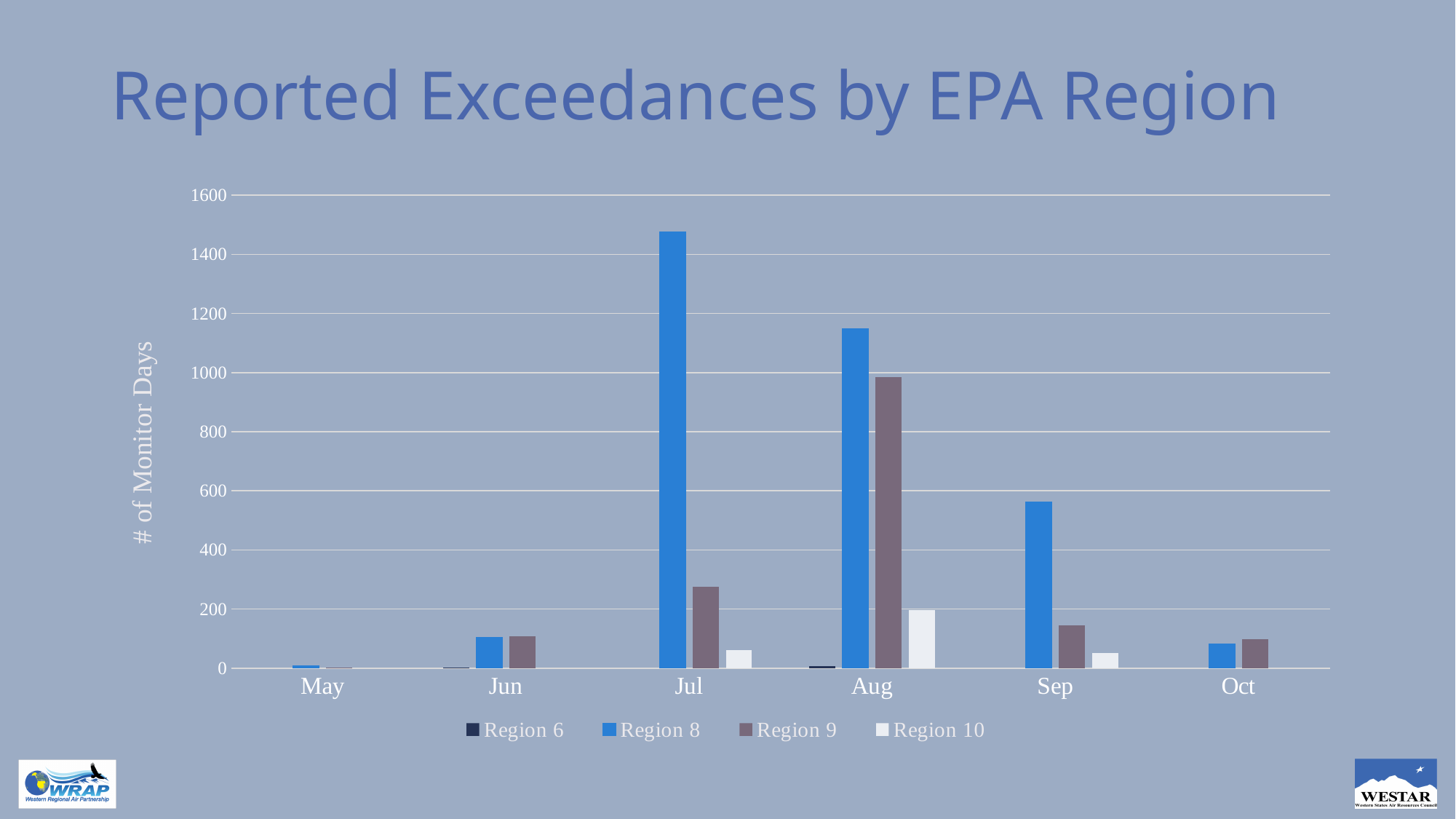
How many months are shown along the x axis? 6 What kind of chart is shown on the slide? bar chart How many series does the legend list? 4 In Jul, which is larger: Region 8 or Region 9? Region 8 Is the value for Region 8 in Aug greater or less than 1200? less Is the value for Region 9 in Aug greater or less than 800? greater In which month is the Region 8 bar highest? Jul What is the label on the y axis? # of Monitor Days In which month is the Region 9 bar highest? Aug Is the value for Region 8 in Sep greater or less than 600? less What is the title of the chart? Reported Exceedances by EPA Region